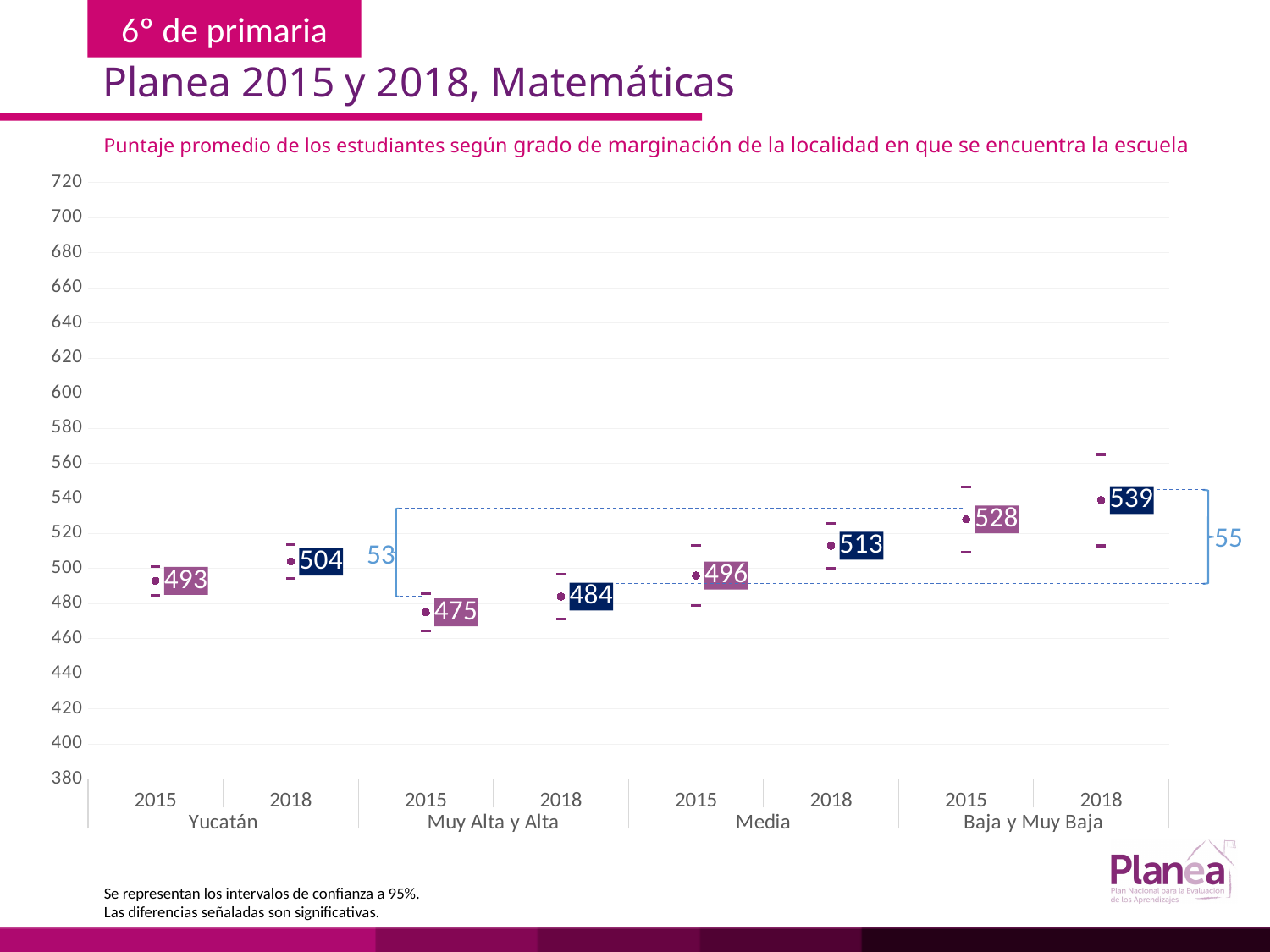
Which group and year has the highest average score? Baja y Muy Baja, 2018 What is the average score for Media in 2018? 513 What is the average score for Muy Alta y Alta in 2015? 475 What is the difference between the 2018 scores of Baja y Muy Baja and Muy Alta y Alta? 55 How many data points are plotted on the chart? 8 Which is larger, the 2018 score for Yucatán or the 2015 score for Media? 2018 score for Yucatán Which group and year has the lowest average score? Muy Alta y Alta, 2015 What is the average score for Yucatán in 2015? 493 Is the 2015 score for Baja y Muy Baja greater or less than 520? greater Does the score rise or fall from 2015 to 2018 within each group? rise What is the average score for Baja y Muy Baja in 2018? 539 What is the difference between the 2018 and 2015 scores for Media? 17